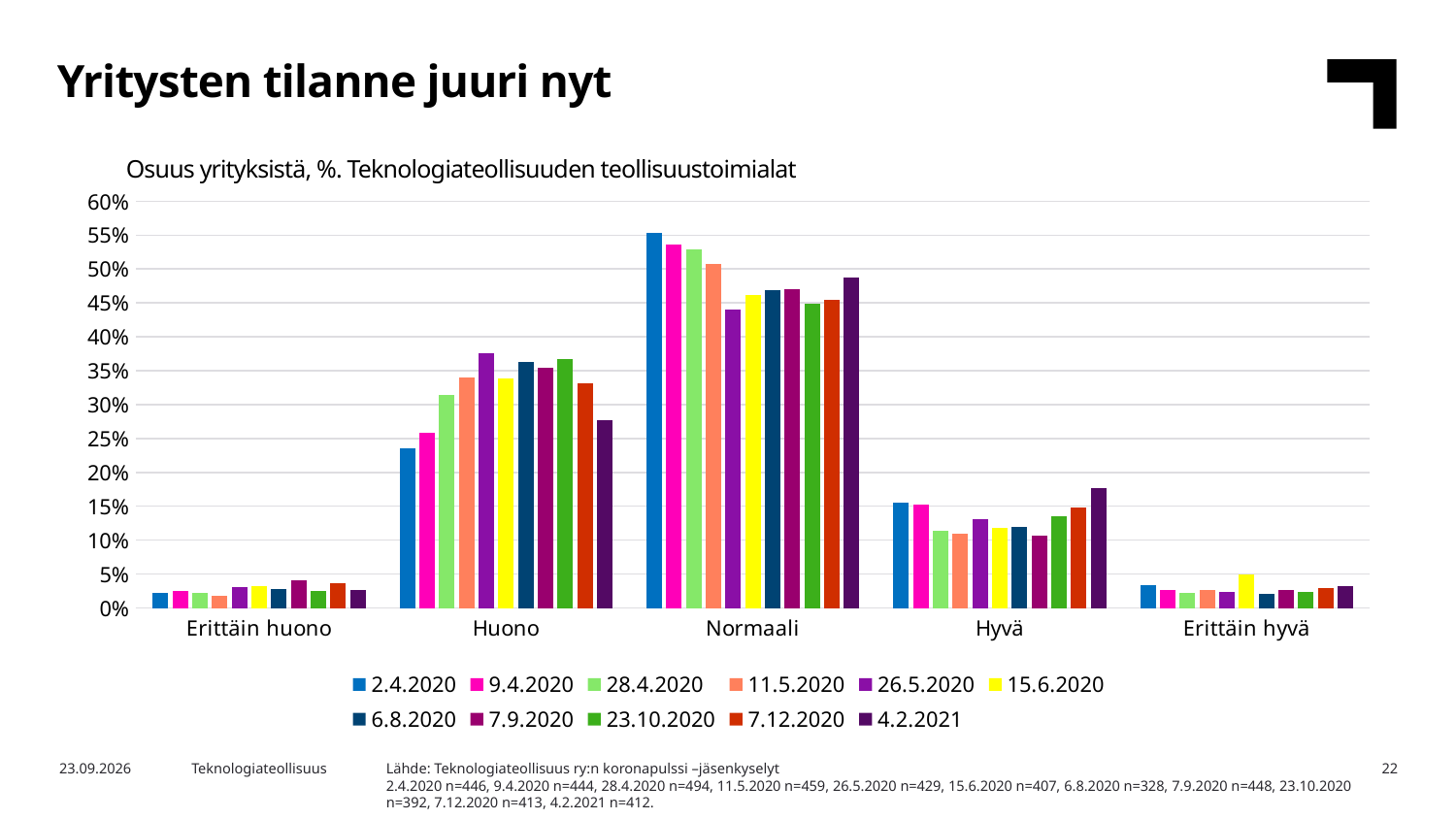
What kind of chart is shown on the slide? bar chart What is the subtitle text shown above the chart? Osuus yrityksistä, %. Teknologiateollisuuden teollisuustoimialat Is the value for Erittäin huono in the 26.5.2020 series greater or less than 5%? less How many series does the chart legend list? 11 Is the value for Huono in the 2.4.2020 series greater or less than 20%? greater Which category has the highest value for the 2.4.2020 series? Normaali Within the Huono category, which series has the lowest value? 2.4.2020 Is the value for Normaali in the 2.4.2020 series greater or less than 50%? greater For the Hyvä category, which is larger: the 26.5.2020 value or the 4.2.2021 value? 4.2.2021 For the Huono category, which is larger: the 2.4.2020 value or the 26.5.2020 value? 26.5.2020 How many categories are shown on the x axis of the chart? 5